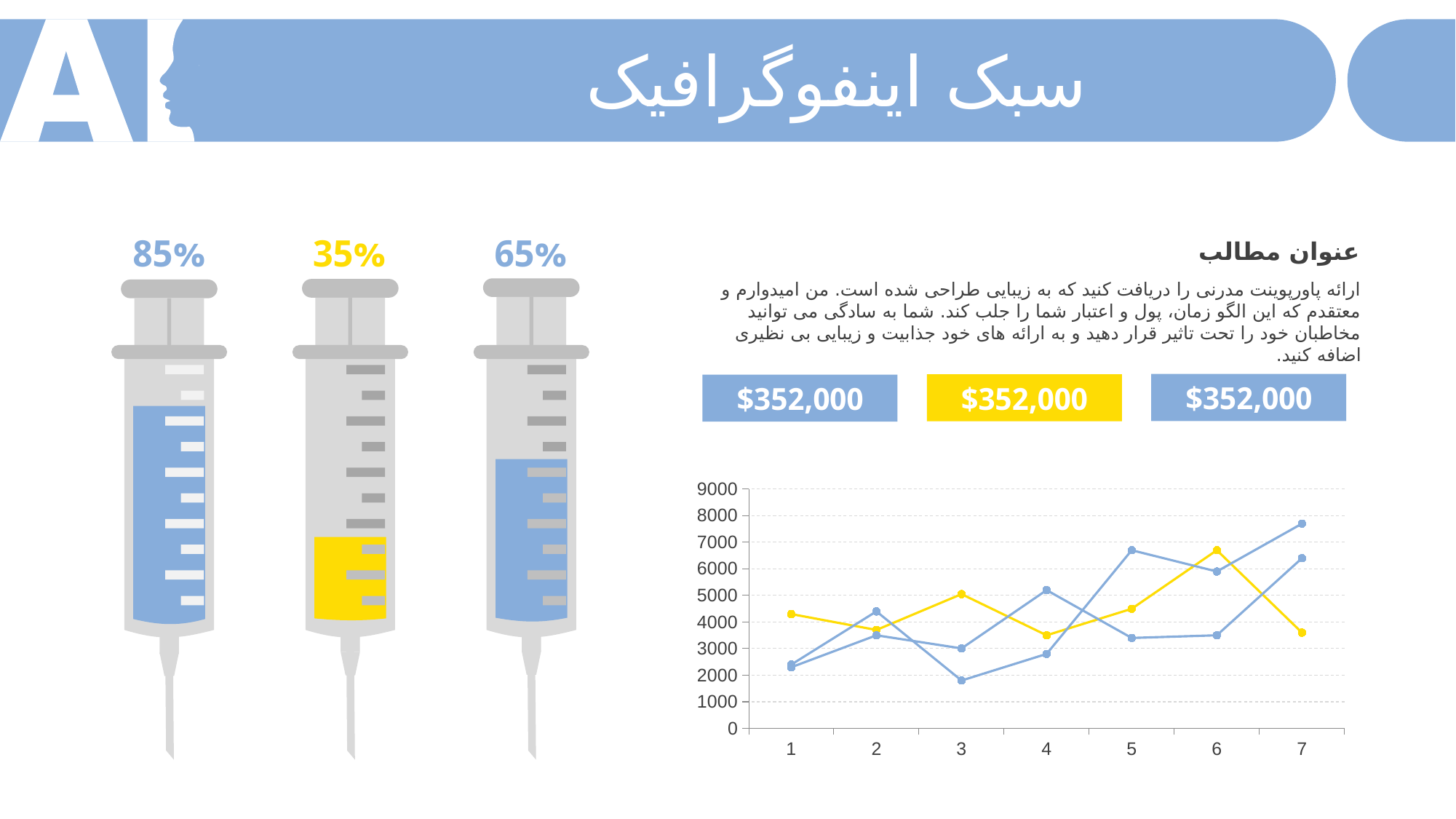
How many lines are plotted in the line chart? 3 How many points are on the x axis of the line chart? 7 What kind of chart is shown on the right side of the slide? line chart In the line chart, at x = 7, is the yellow line above or below both blue lines? below In the line chart, at which x-axis value does the yellow line reach its highest point? 6 In the line chart, at which x-axis value does the chart reach its highest point overall? 7 In the line chart, at x = 1, is the yellow line above or below both blue lines? above In the line chart, is the yellow line's value at x = 6 greater or less than 6000? greater What is the highest value shown on the y axis of the line chart? 9000 In the line chart, is the yellow line's value at x = 7 greater or less than 4000? less What colours are the lines in the line chart? blue and yellow In the line chart, is the yellow line's value at x = 1 greater or less than 3000? greater